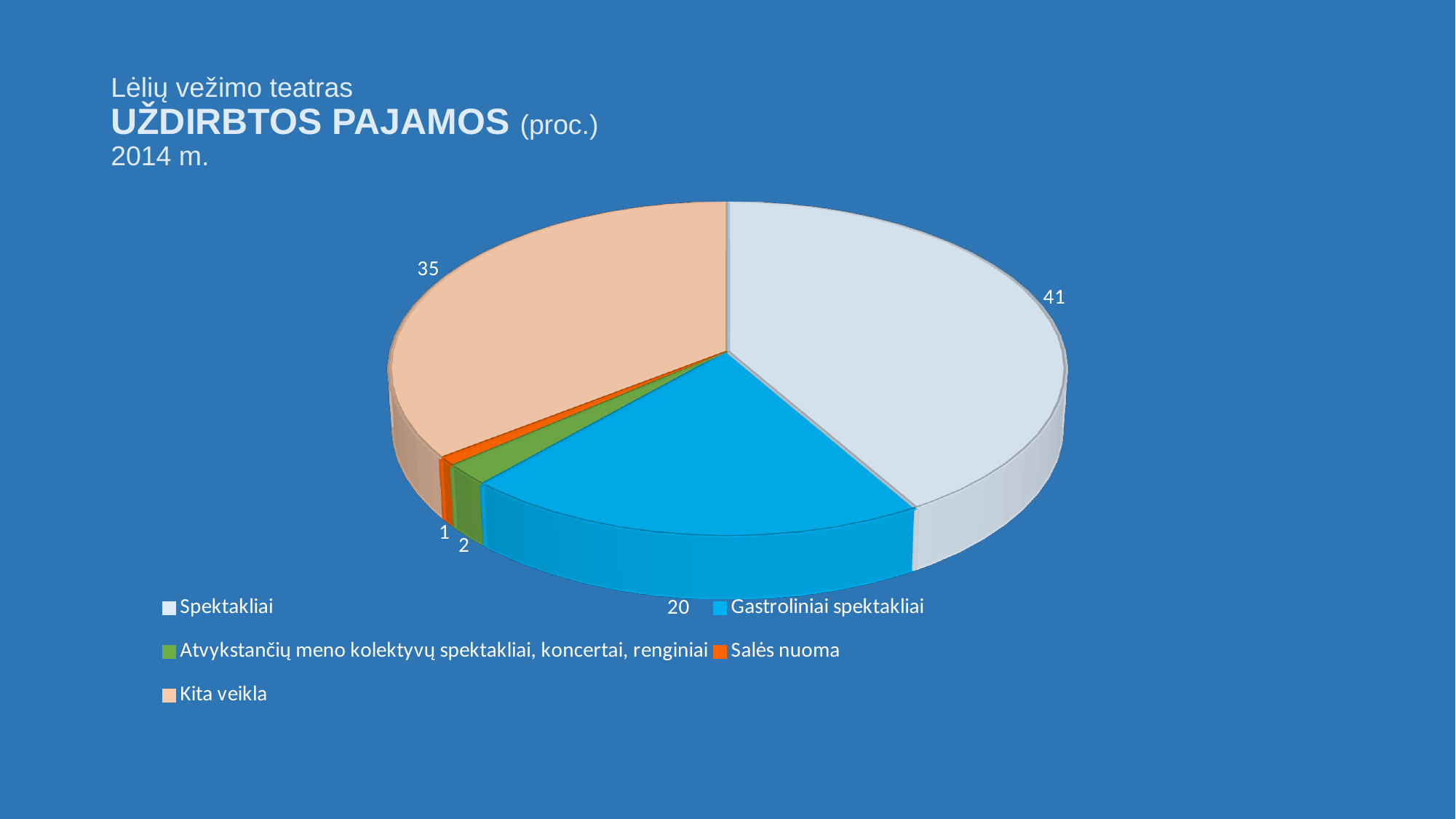
Which year does the chart title refer to? 2014 m. What is the value for Spektakliai? 41 What is the value for Salės nuoma? 1 Which category has the smallest share of the pie? Salės nuoma Which category has the largest share of the pie? Spektakliai What is the value for Kita veikla? 35 How many categories does the pie chart have? 5 What is the difference between the values for Spektakliai and Kita veikla? 6 What type of chart is shown on the slide? pie chart Which is larger, the value for Gastroliniai spektakliai or the value for Kita veikla? Kita veikla What is the value for Gastroliniai spektakliai? 20 What is the value for Atvykstančių meno kolektyvų spektakliai, koncertai, renginiai? 2